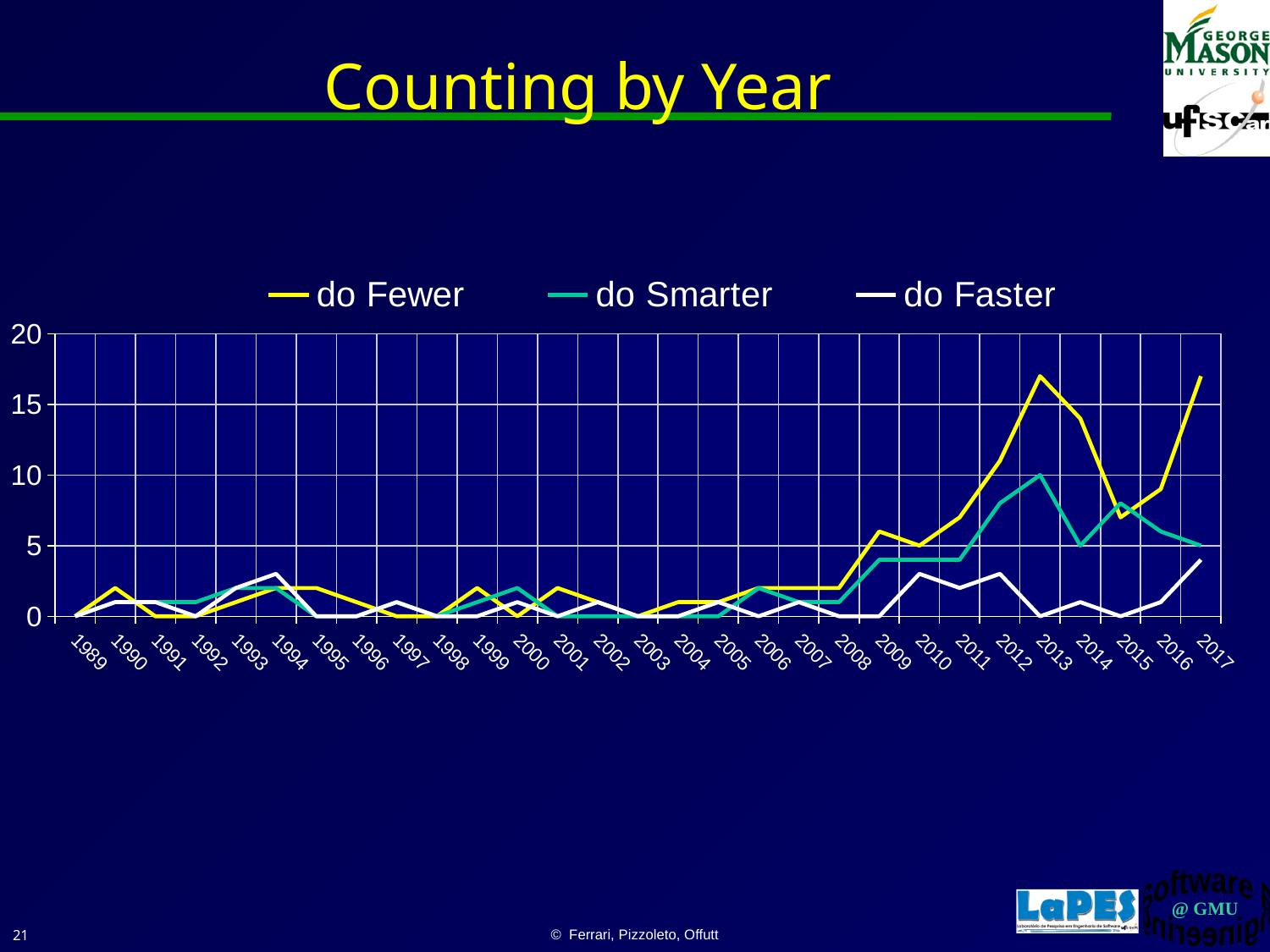
Does the do Smarter line rise or fall from 2013 to 2017? fall Which series is drawn in yellow? do Fewer What is the title of the chart? Counting by Year In 2014, which is larger: do Fewer or do Smarter? do Fewer Is the value for do Faster in 2013 greater or less than 5? less Is the value for do Fewer in 2013 greater or less than 15? greater How many series does the legend list? 3 What type of chart is shown on the slide? line chart What is the value of do Smarter in 2013? 10 In which year does do Smarter reach its highest value? 2013 What is the value of do Fewer in 2010? 5 How many years are shown along the x axis? 29